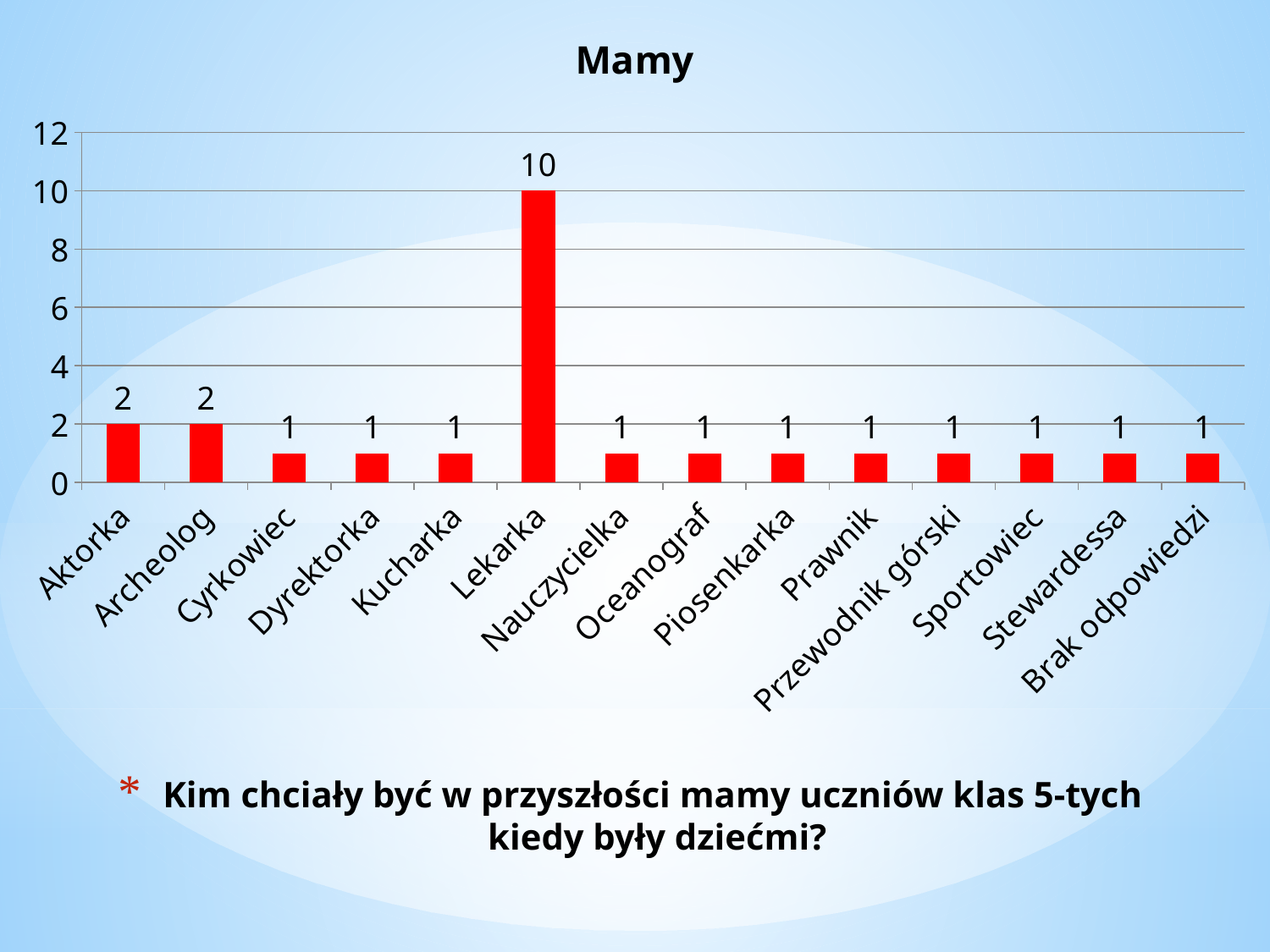
What is the title of the chart? Mamy What is the value for Brak odpowiedzi? 1 What is the value for Przewodnik górski? 1 Is the value for Lekarka greater or less than 8? greater What is the value for Aktorka? 2 How many categories are shown on the x axis? 14 What is the value for Lekarka? 10 What kind of chart is shown on the slide? bar chart Which category has the highest value? Lekarka Which is larger, the value for Aktorka or the value for Cyrkowiec? Aktorka What is the difference between the values for Lekarka and Archeolog? 8 What colour are the bars in the chart? red